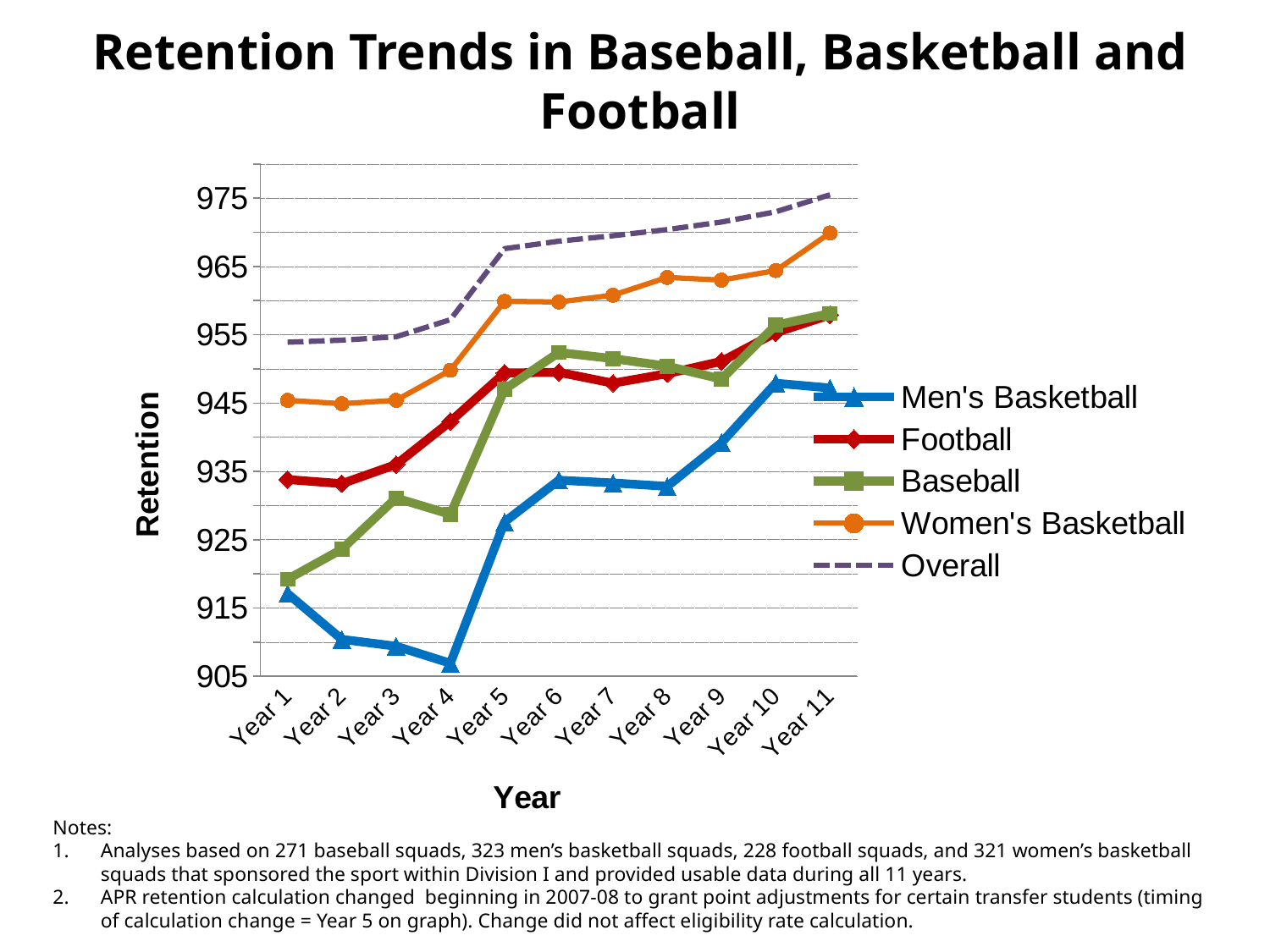
In Year 1, which has the higher retention: Football or Men's Basketball? Football Is the Men's Basketball retention value for Year 4 greater or less than 915? less In which year is the Men's Basketball retention lowest? Year 4 Is the Women's Basketball retention value for Year 11 greater or less than 965? greater How many series does the legend list? 5 Does the Overall retention line rise or fall from Year 1 to Year 11? Rise How many years are plotted along the x axis? 11 Is the Football retention value for Year 1 greater or less than 925? greater In Year 1, which has the higher retention: Baseball or Women's Basketball? Women's Basketball What kind of chart is shown on the slide? Line chart Which series is drawn with a dashed line? Overall In which year is the Women's Basketball retention highest? Year 11